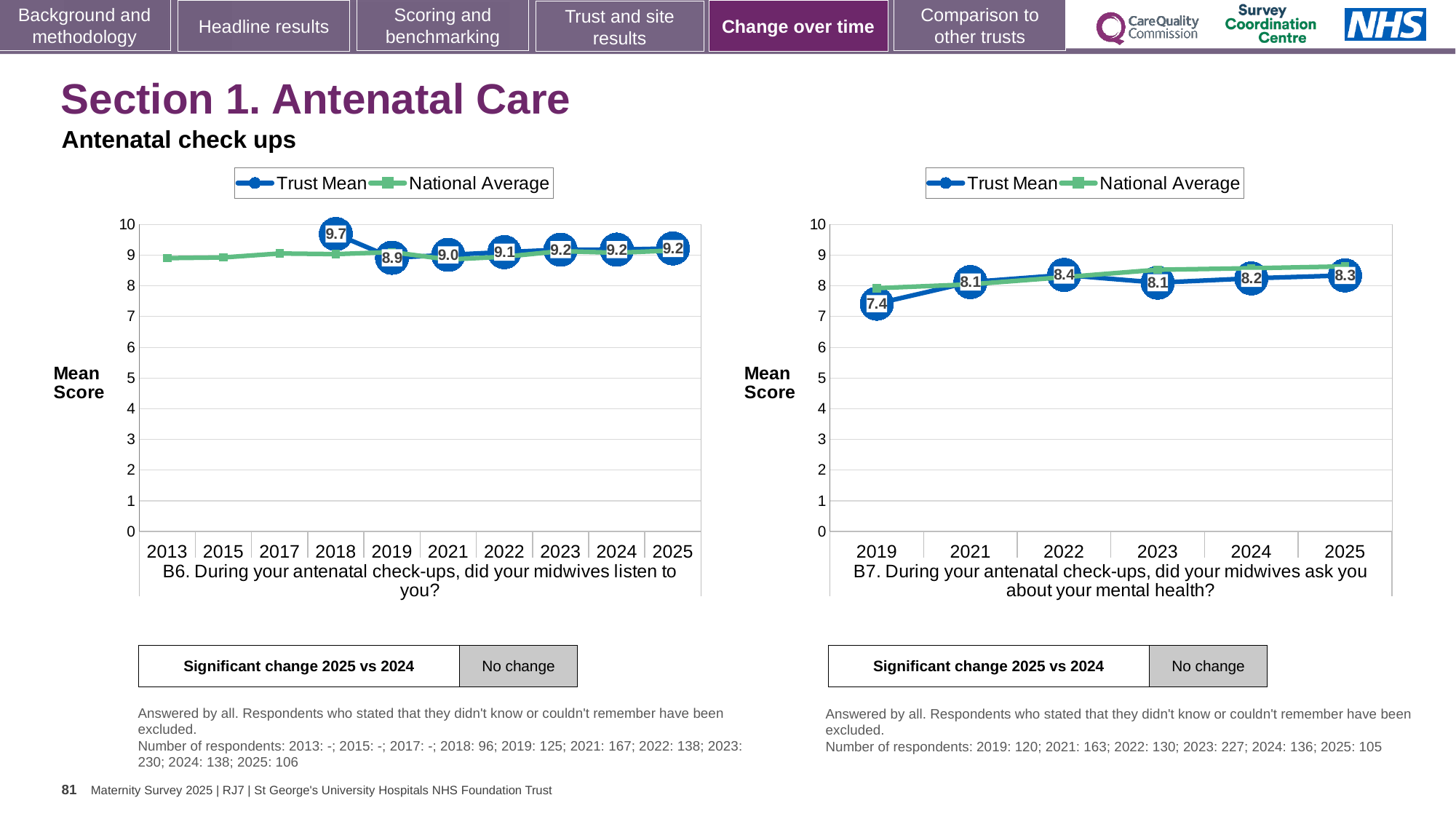
On the right chart (B7), is the Trust Mean for 2022 larger or smaller than the Trust Mean for 2023? larger On the left chart (B6), what is the Trust Mean value for 2019? 8.9 On the right chart (B7), what is the Trust Mean value for 2025? 8.3 On the left chart (B6), what is the difference between the Trust Mean in 2018 and in 2019? 0.8 On the right chart (B7), what is the Trust Mean value for 2019? 7.4 On the left chart (B6), which year has the lowest labelled Trust Mean value? 2019 On the left chart (B6), how many years are shown on the x axis? 10 On the right chart (B7), which year has the highest Trust Mean value? 2022 What type of chart is the right chart (B7)? line chart On the left chart (B6), which year has the highest Trust Mean value? 2018 On the right chart (B7), how many series does the legend list? 2 On the left chart (B6), what is the Trust Mean value for 2018? 9.7